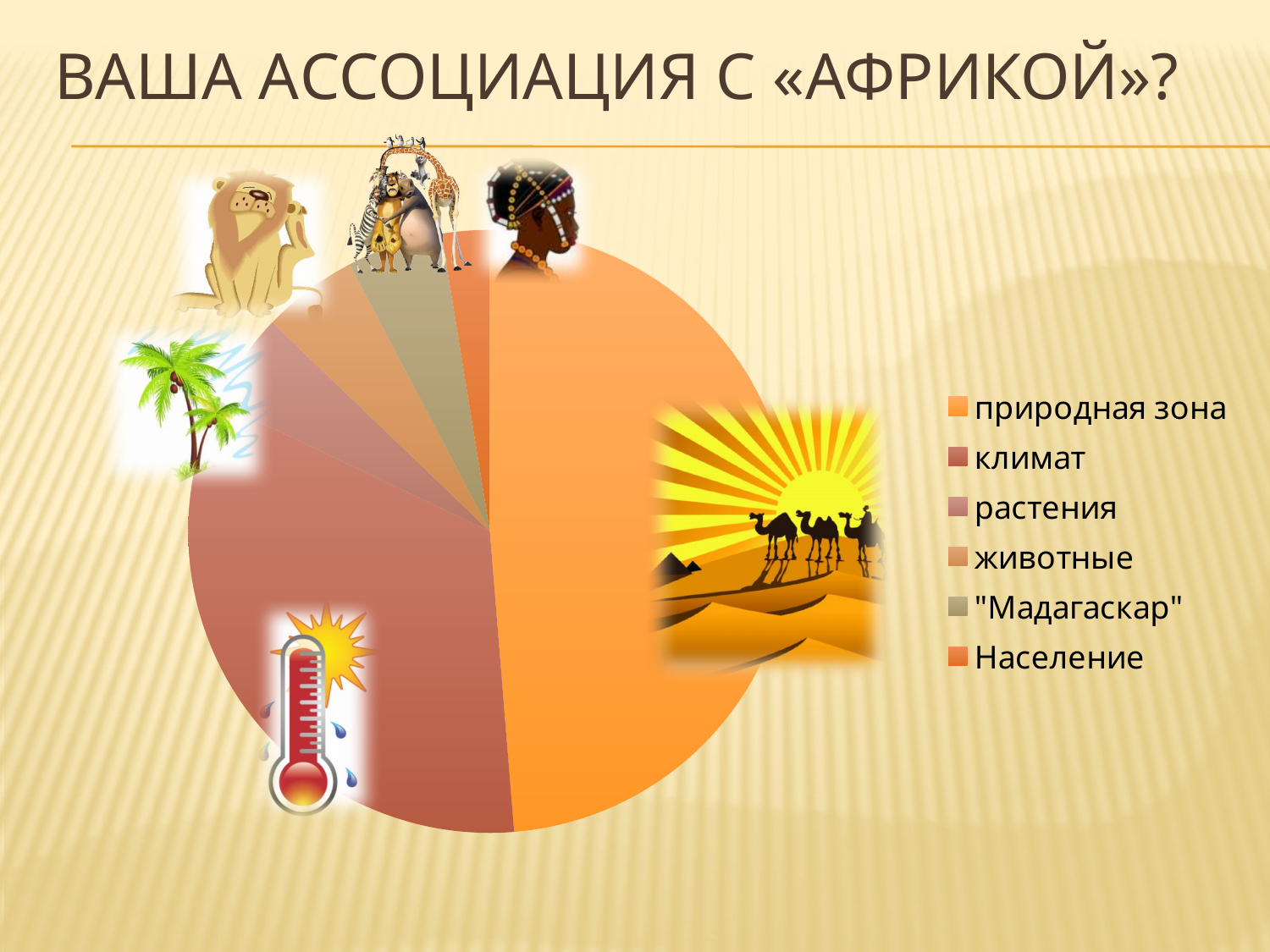
Which slice is larger: растения or Население? растения What is the title of the slide containing the pie chart? Ваша ассоциация с «Африкой»? Which category has the second-largest slice of the pie chart? климат Which slice is larger: климат or растения? климат Which slice is larger: природная зона or климат? природная зона Which category has the largest slice of the pie chart? природная зона How many categories (slices) does the pie chart have? 6 What kind of chart is shown on the slide? pie chart Which legend entry is listed first in the pie chart's legend? природная зона Which category has the smallest slice of the pie chart? Население